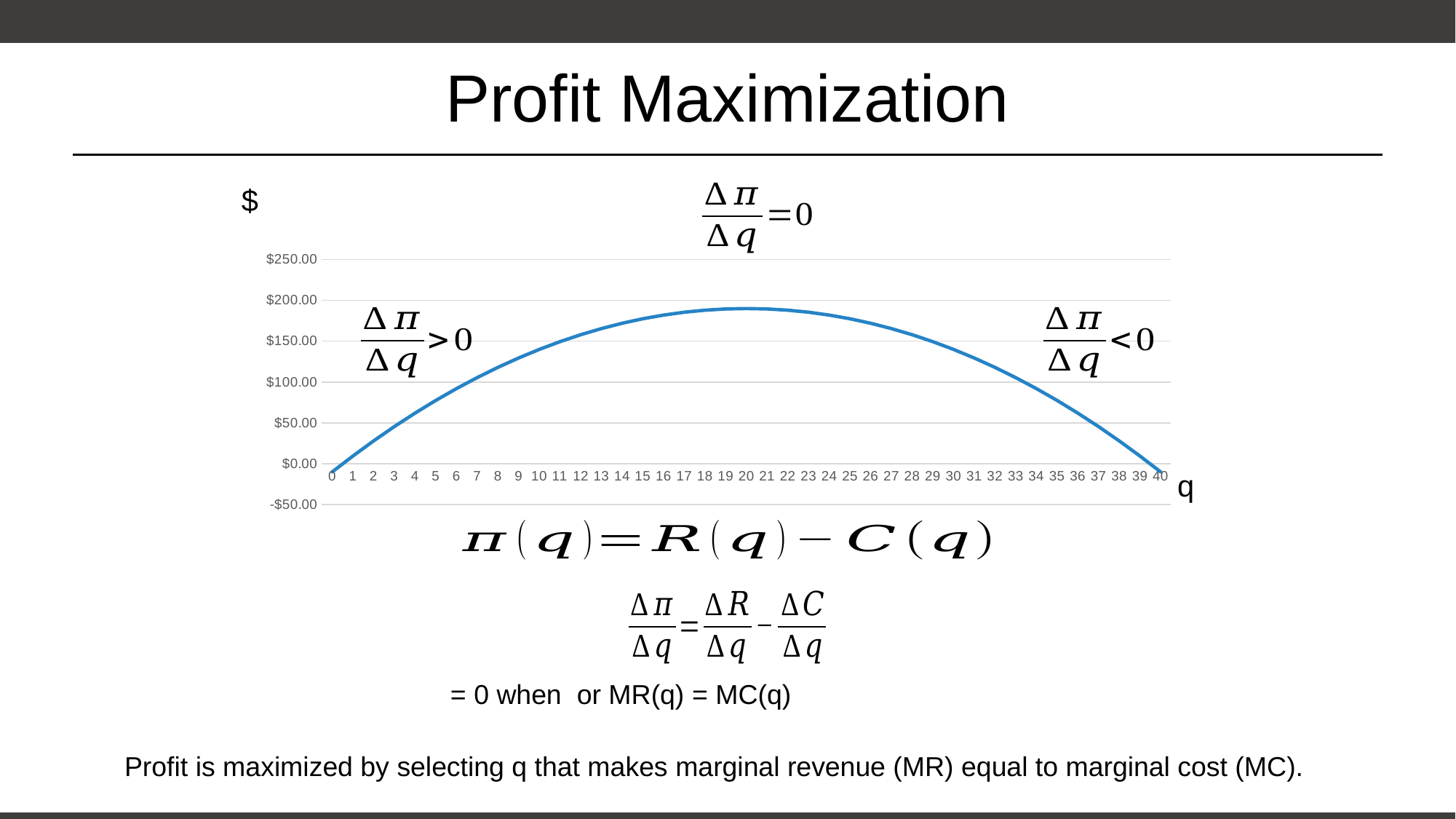
What kind of chart is shown on the slide? line chart Does the curve rise or fall as q increases from 0 to 20? rise Is the value of the curve at q = 5 greater or less than $100.00? less Is the value of the curve at q = 20 greater or less than $200.00? less How many points are plotted along the x axis (q from 0 to 40)? 41 Is the value of the curve at q = 35 greater or less than $100.00? less What is the highest tick label shown on the vertical axis? $250.00 Does the curve rise or fall as q increases from 20 to 40? fall At which value of q does the profit curve reach its highest point? 20